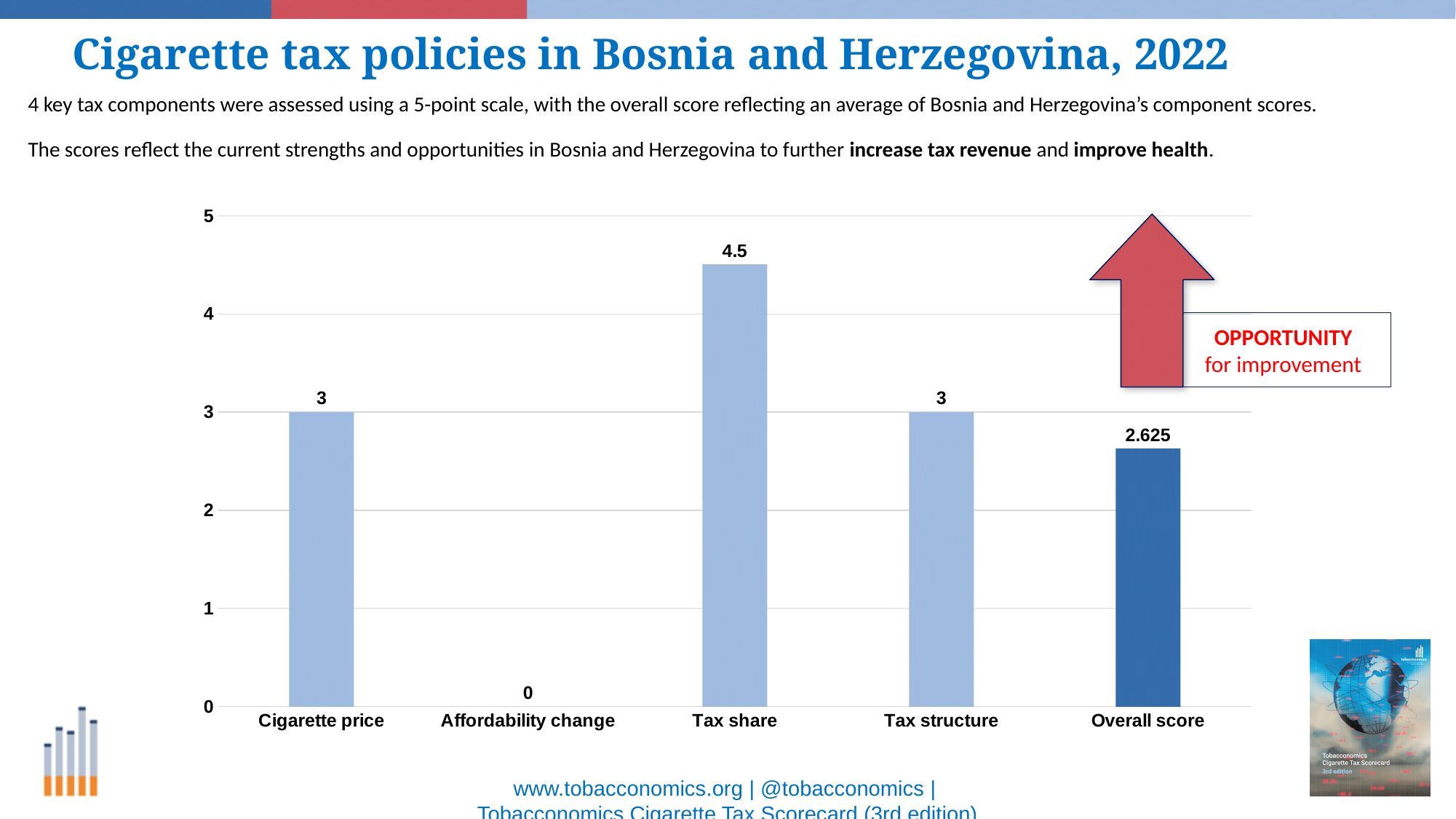
What is the value for Cigarette price? 3 How many categories are shown on the x axis? 5 Which is larger, the value for Cigarette price or the value for Overall score? Cigarette price What is the value for Tax share? 4.5 Which category has the highest value? Tax share What is the value for Affordability change? 0 What is the value for Overall score? 2.625 What is the difference between the values for Tax share and Tax structure? 1.5 Which category has the lowest value? Affordability change Which bar is shown in a darker blue than the others? Overall score Is the value for Tax share greater or less than 4? greater What kind of chart is shown on the slide? Bar chart